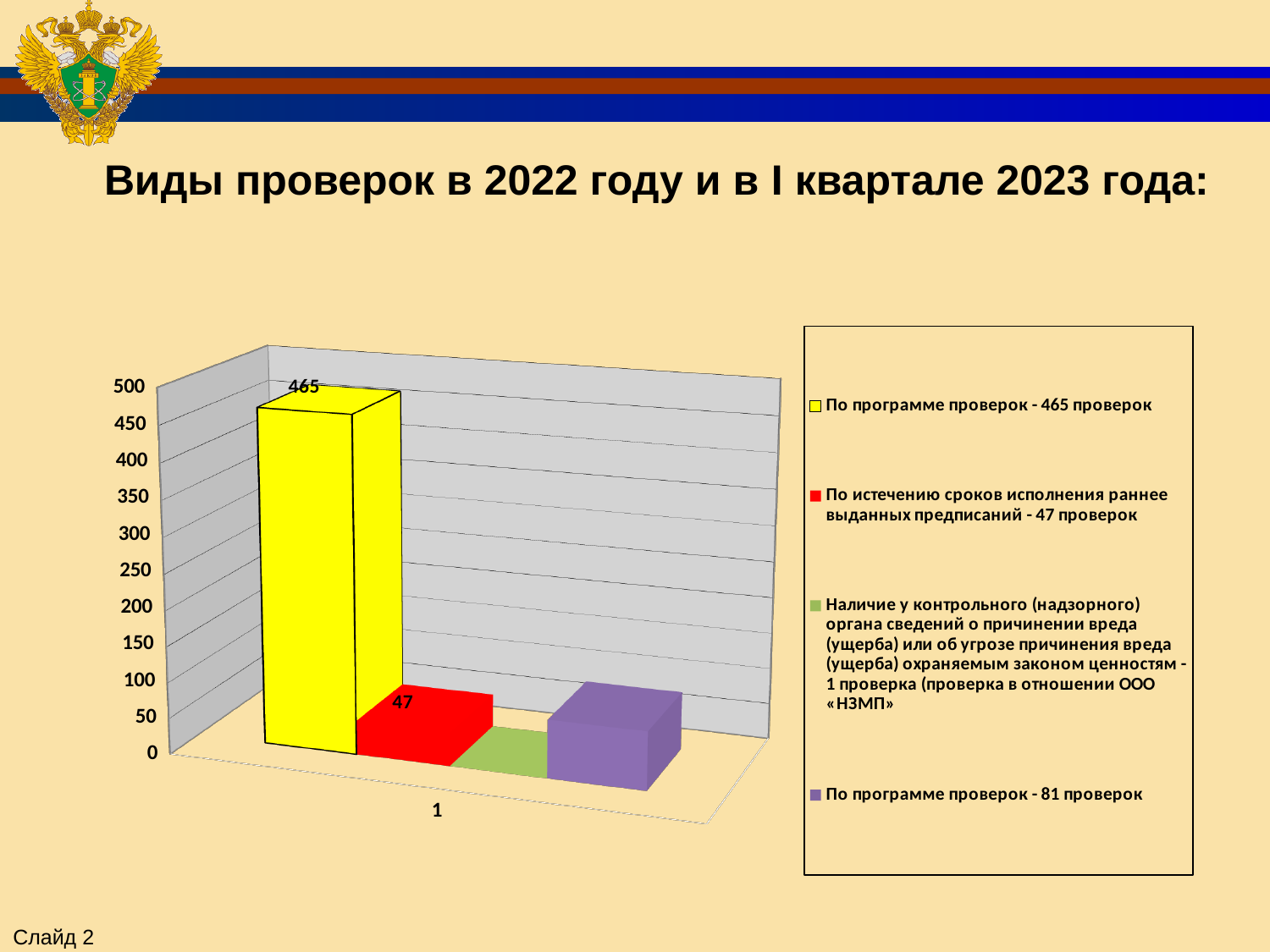
What value is labelled on the yellow bar (По программе проверок)? 465 What type of chart is shown on the slide? bar chart Is the value of the purple bar greater or less than 200? less Which series has the lowest value? Наличие у контрольного (надзорного) органа сведений о причинении вреда (ущерба) - 1 проверка Which series has the highest value? По программе проверок - 465 проверок What value is labelled on the red bar (По истечению сроков исполнения раннее выданных предписаний)? 47 Which is larger, the yellow bar or the red bar? the yellow bar What is the difference between the yellow bar (465) and the red bar (47)? 418 According to the legend, how many проверок correspond to the purple series (По программе проверок)? 81 What is the title of the slide above the chart? Виды проверок в 2022 году и в I квартале 2023 года: How many series does the legend list? 4 According to the legend, how many проверок correspond to the green series (Наличие у контрольного (надзорного) органа сведений о причинении вреда)? 1